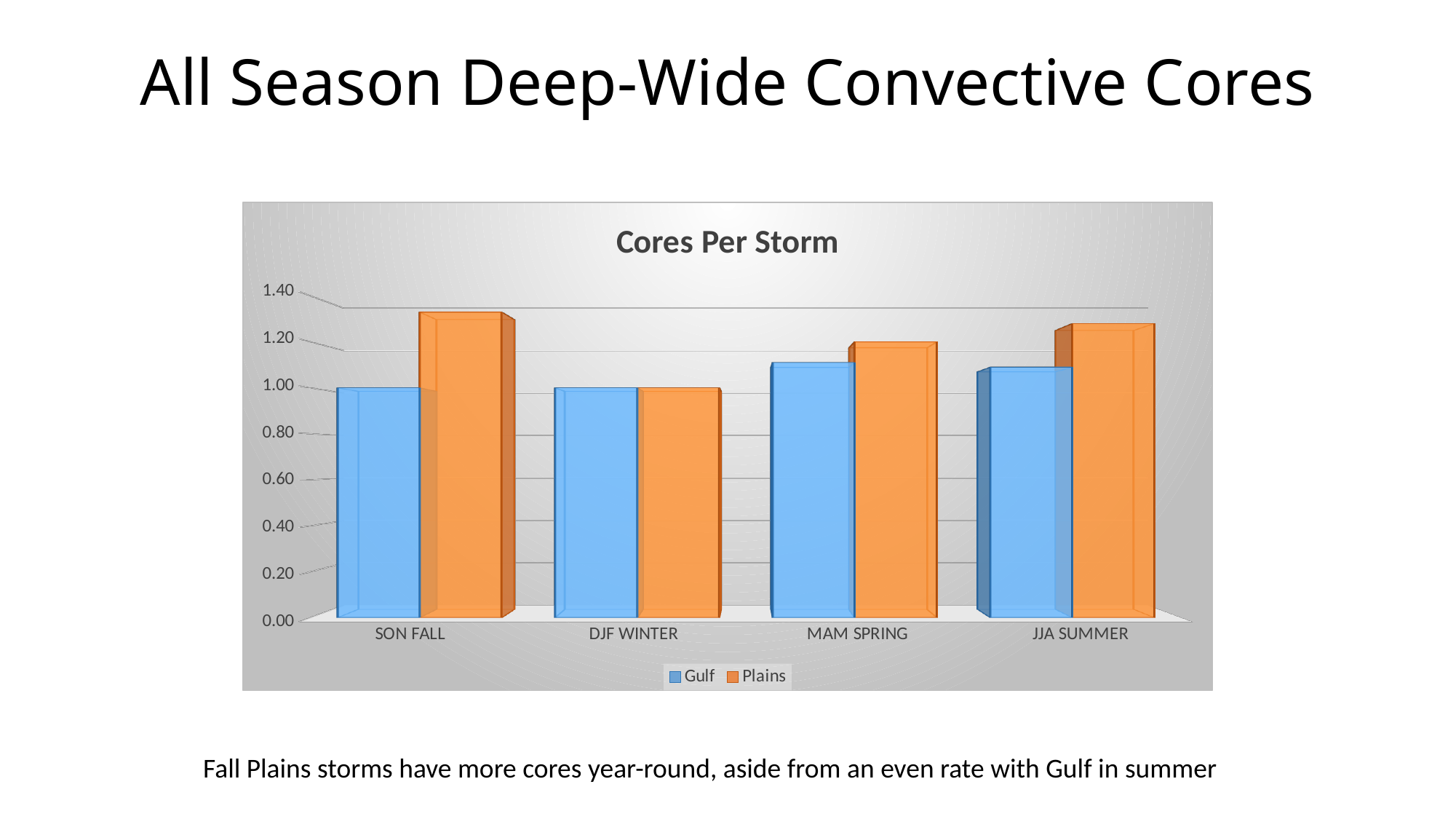
For JJA SUMMER, which series has the larger value, Gulf or Plains? Plains How many season categories are shown on the x axis? 4 For which season is the Plains value highest? SON FALL For SON FALL, which series has the larger value, Gulf or Plains? Plains Is the Plains value for SON FALL greater or less than 1.20? greater Which series is shown in orange? Plains What kind of chart is shown on the slide? bar chart How many series does the legend list? 2 For which season is the Plains value lowest? DJF WINTER What is the title of the chart? Cores Per Storm Is the Gulf value for MAM SPRING greater or less than 1.00? greater Is the Gulf value for SON FALL greater or less than 1.20? less